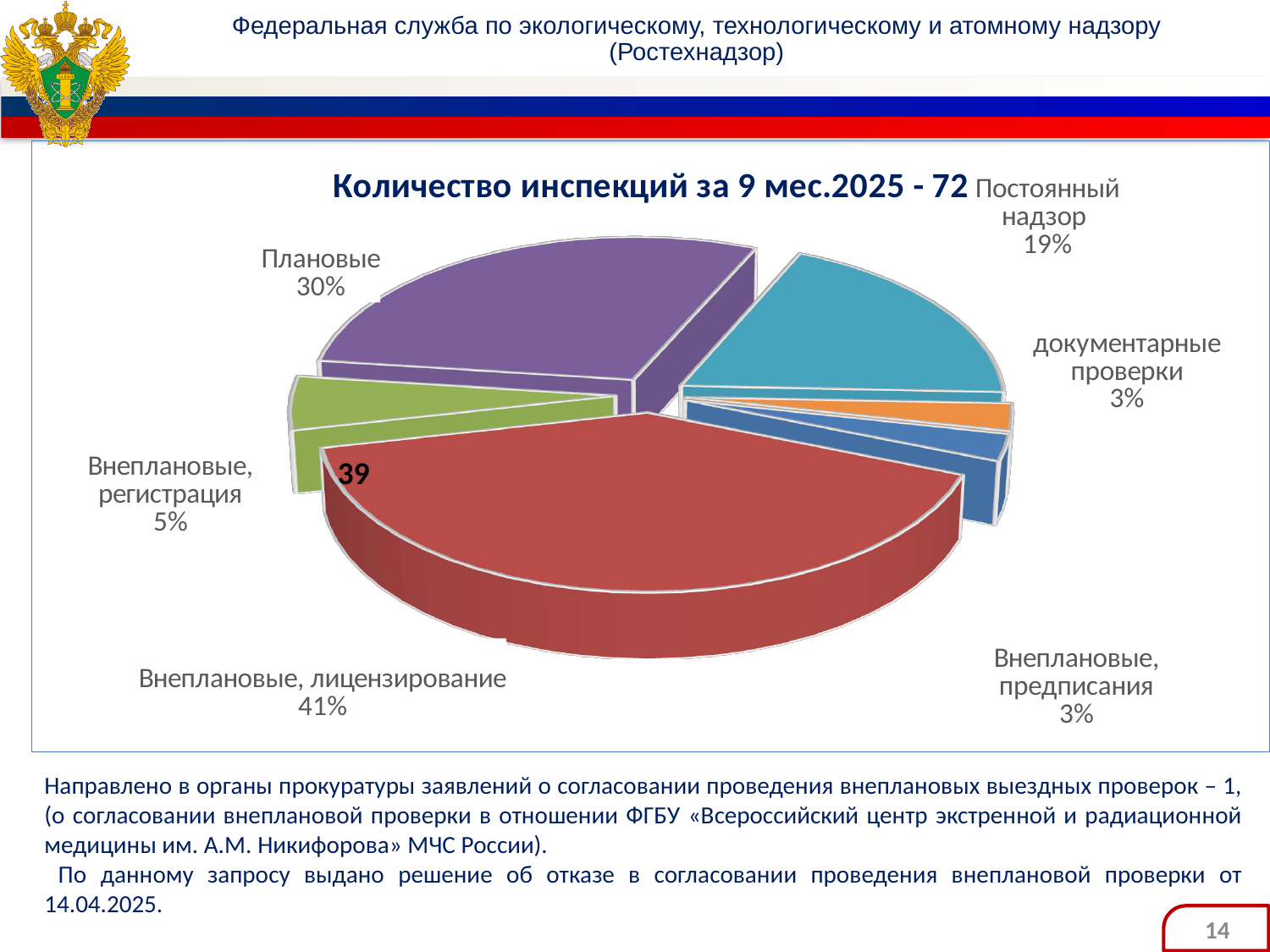
What number is printed on the "Внеплановые, лицензирование" slice? 39 How many categories (slices) does the pie chart have? 6 What share of the pie does "Плановые" take? 30% What is the difference in percentage points between "Внеплановые, лицензирование" and "Плановые"? 11 What kind of chart is shown on the slide? pie chart What share of the pie does "Внеплановые, регистрация" take? 5% What is the title of the chart? Количество инспекций за 9 мес.2025 - 72 What share of the pie does "Внеплановые, лицензирование" take? 41% Which category has the largest share of the pie? Внеплановые, лицензирование Which is larger, the share for "Постоянный надзор" or the share for "Внеплановые, регистрация"? Постоянный надзор